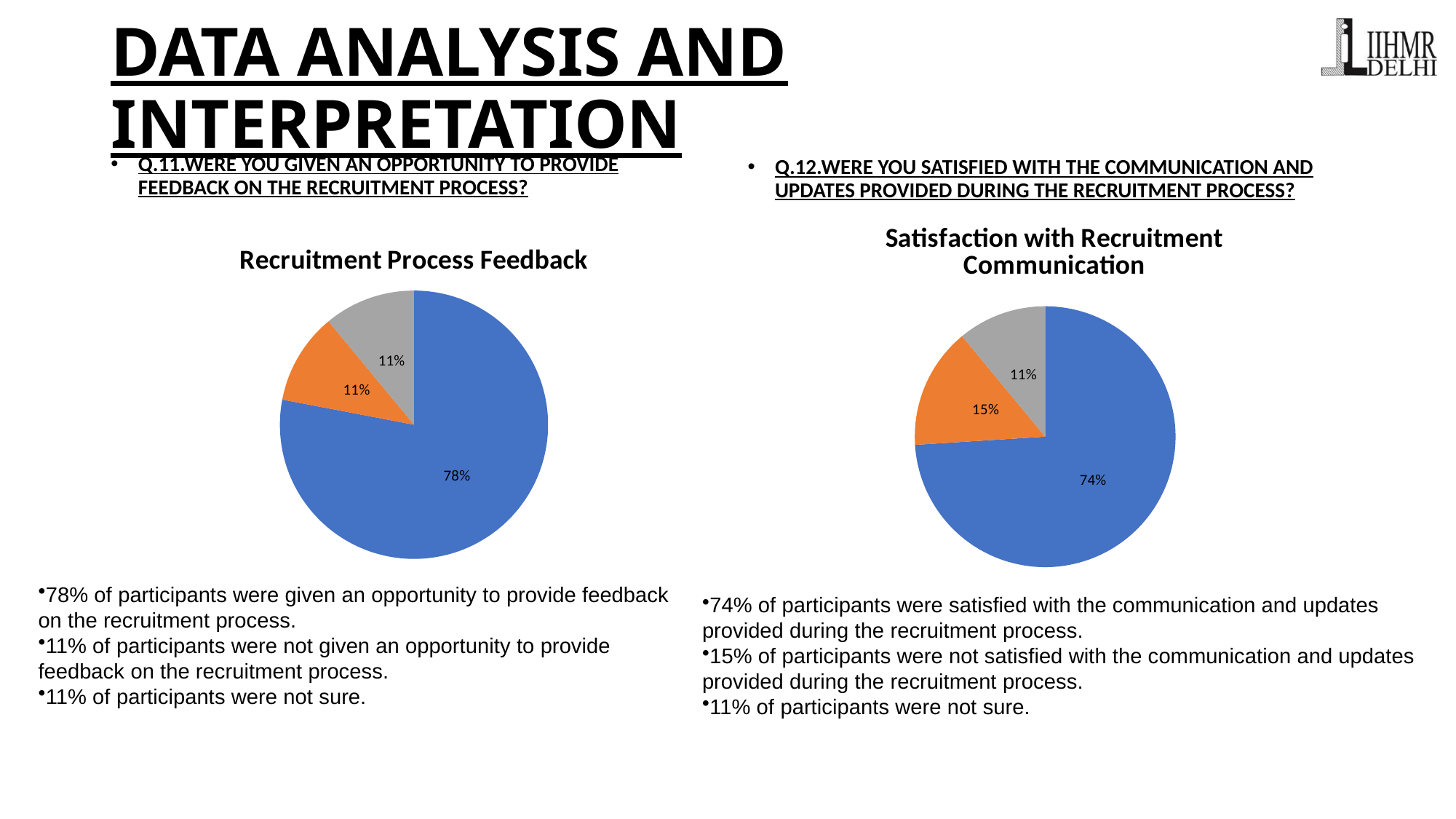
In the "Satisfaction with Recruitment Communication" pie chart, what percentage is shown on the grey slice? 11% In the "Recruitment Process Feedback" pie chart, what is the difference between the largest slice and the grey slice? 67% What is the title of the pie chart on the right side of the slide? Satisfaction with Recruitment Communication In the "Satisfaction with Recruitment Communication" pie chart, what percentage is shown on the blue slice? 74% What kind of chart is the "Recruitment Process Feedback" chart? pie chart In the "Recruitment Process Feedback" pie chart, what percentage is shown on the largest (blue) slice? 78% In the "Recruitment Process Feedback" pie chart, what percentage is shown on the orange slice? 11% In the "Satisfaction with Recruitment Communication" pie chart, what percentage is shown on the orange slice? 15% In the "Satisfaction with Recruitment Communication" pie chart, what is the difference between the blue slice and the orange slice? 59% Which is larger: the orange slice in the "Recruitment Process Feedback" chart or the orange slice in the "Satisfaction with Recruitment Communication" chart? Satisfaction with Recruitment Communication How many slices does the "Satisfaction with Recruitment Communication" pie chart have? 3 How many slices does the "Recruitment Process Feedback" pie chart have? 3